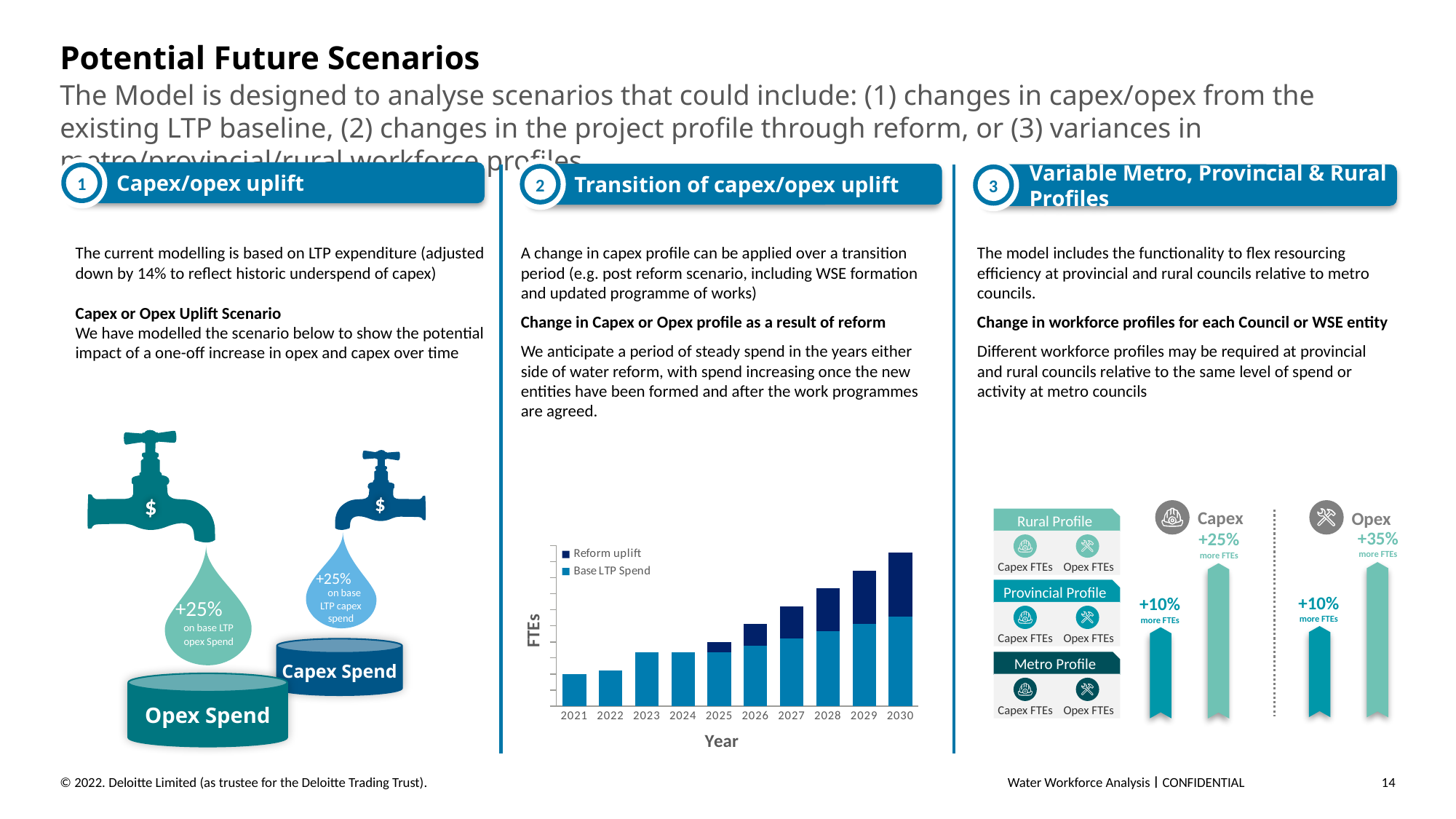
In the FTEs chart, is the Reform uplift segment for 2030 larger or smaller than the Reform uplift segment for 2026? Larger What kind of chart is shown in the 'Transition of capex/opex uplift' panel? Stacked bar chart What is the first year shown on the x axis of the FTEs chart? 2021 How many years are shown on the x axis of the FTEs chart? 10 How many series does the legend of the FTEs chart list? 2 What is the label on the x axis of the chart in the middle panel? Year In the FTEs chart, do the total bar heights rise or fall from 2021 to 2030? Rise In the FTEs chart, is the total bar for 2030 taller or shorter than the total bar for 2025? Taller What is the label on the y axis of the chart in the middle panel? FTEs Which year has the shortest total bar in the FTEs chart? 2021 Which year has the tallest total bar in the FTEs chart? 2030